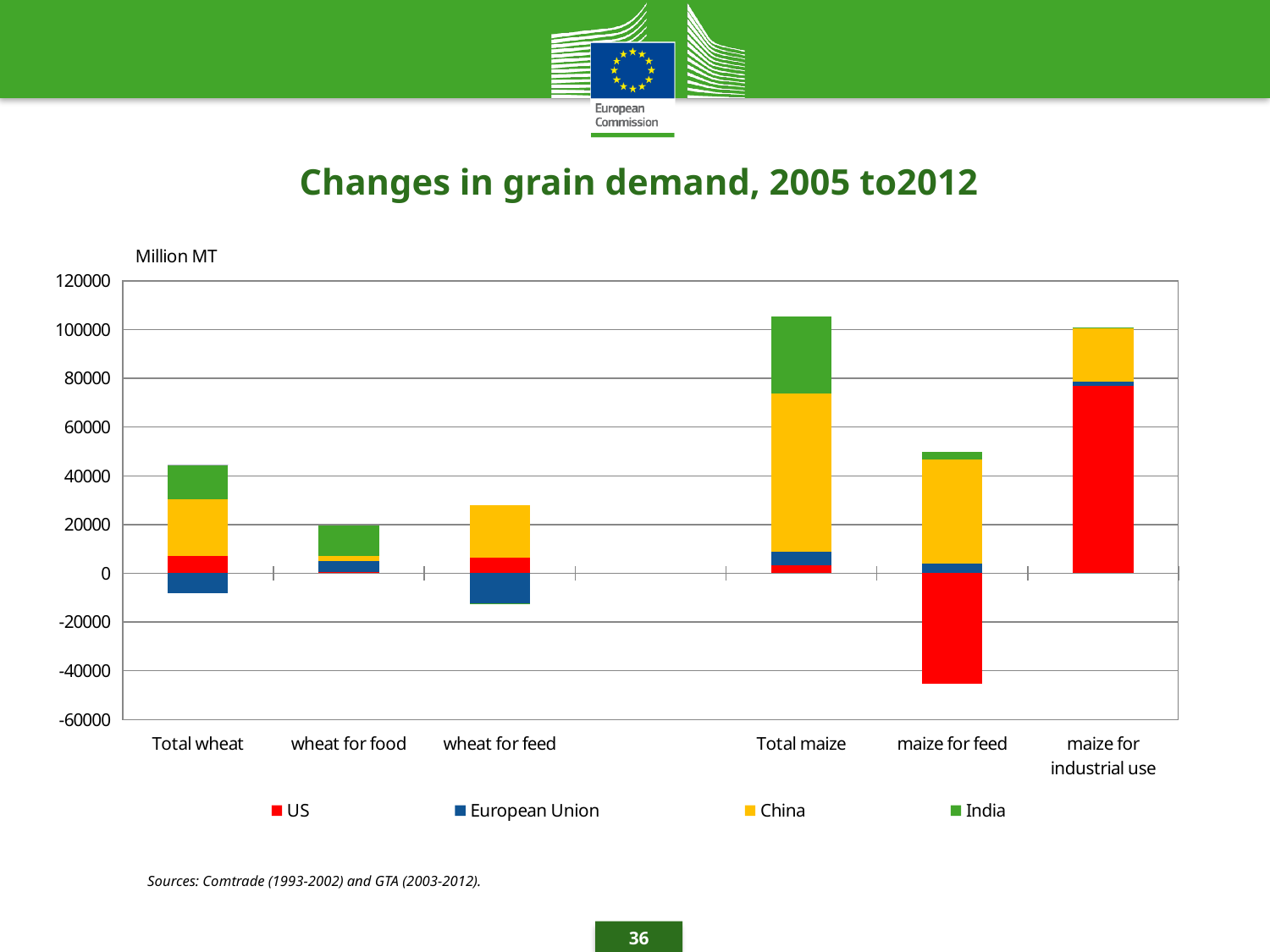
Is the US value for maize for feed greater or less than -40000? less Which series has a negative value for maize for feed? US How many series does the legend list? 4 Is the US value for maize for industrial use greater or less than 60000? greater What is the title of the chart? Changes in grain demand, 2005 to2012 How many labelled categories are shown on the x axis? 6 Which is larger, the total positive stack for Total maize or for Total wheat? Total maize What kind of chart is shown on the slide? Stacked bar chart Which category has the largest negative value for the US series? maize for feed Is the China value for Total maize greater or less than 40000? greater What unit is shown on the y axis of the chart? Million MT